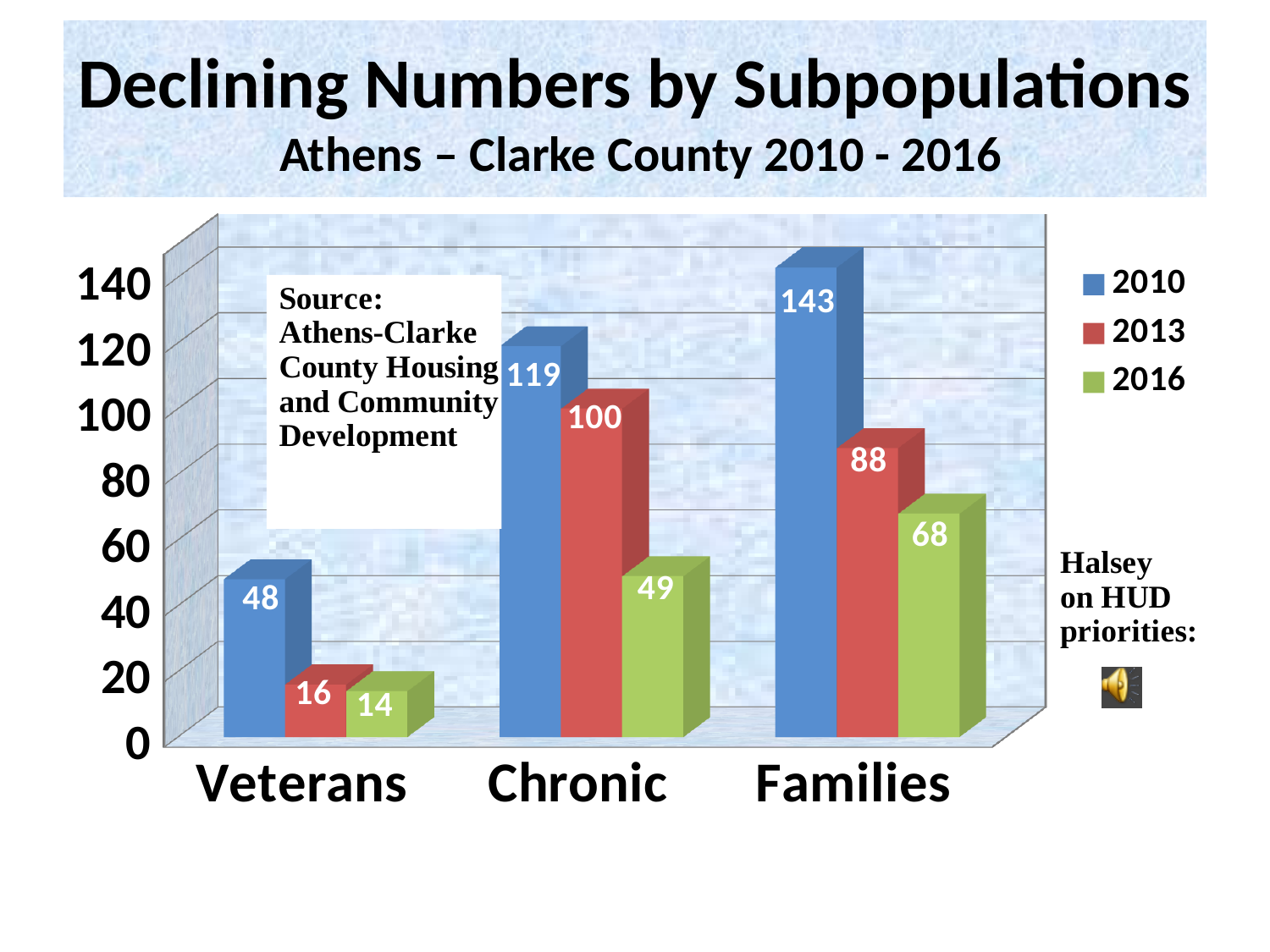
Is the value for Families in 2010 greater or less than 140? greater What is the value for Veterans in 2010? 48 Which category has the highest value in 2010? Families What is the value for Chronic in 2013? 100 Which category has the lowest value in 2016? Veterans How many series does the legend list? 3 What kind of chart is shown on the slide? bar chart Which is larger, the 2013 value for Families or the 2013 value for Chronic? Chronic How many categories are shown on the x axis? 3 Do the values for Families rise or fall from 2010 to 2016? fall What is the value for Families in 2016? 68 What is the difference between the 2010 and 2016 values for Chronic? 70